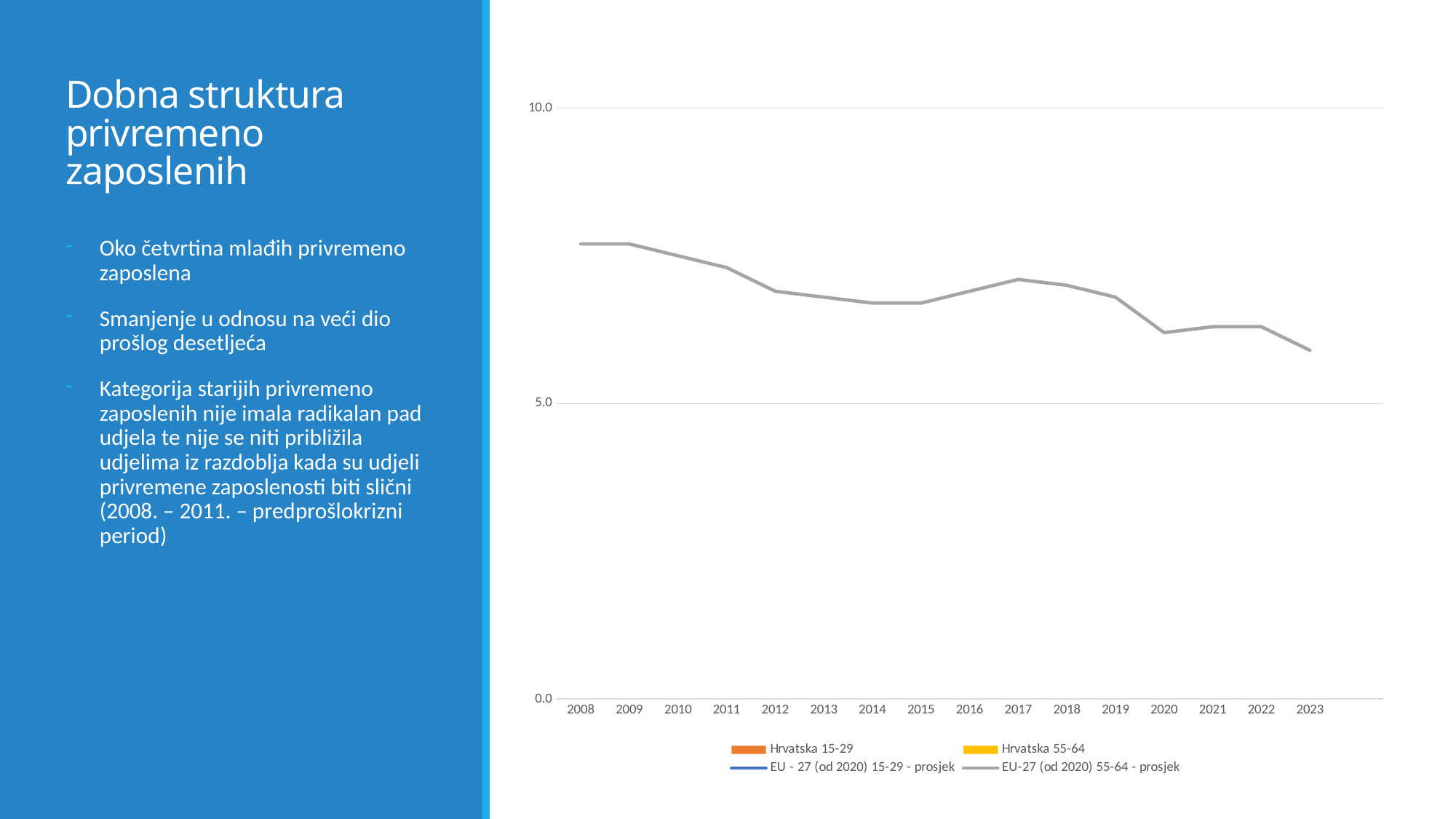
Is the value of the EU-27 (od 2020) 55-64 - prosjek line in 2023 greater or less than 5.0? greater Is the value of the EU-27 (od 2020) 55-64 - prosjek line in 2008 greater or less than 5.0? greater What is the first year shown on the x axis of the chart? 2008 In which year does the EU-27 (od 2020) 55-64 - prosjek line reach its lowest value? 2023 How many series does the chart legend list? 4 Is the value of the EU-27 (od 2020) 55-64 - prosjek line in 2008 greater or less than 10.0? less What kind of chart is shown on the slide? line chart How many years are shown along the x axis of the chart? 16 What colour is the legend marker for the series Hrvatska 15-29? orange For the EU-27 (od 2020) 55-64 - prosjek line, is the value higher in 2008 or in 2023? 2008 Does the plotted EU-27 (od 2020) 55-64 - prosjek line generally rise or fall from 2008 to 2023? fall For the EU-27 (od 2020) 55-64 - prosjek line, is the value higher in 2019 or in 2020? 2019